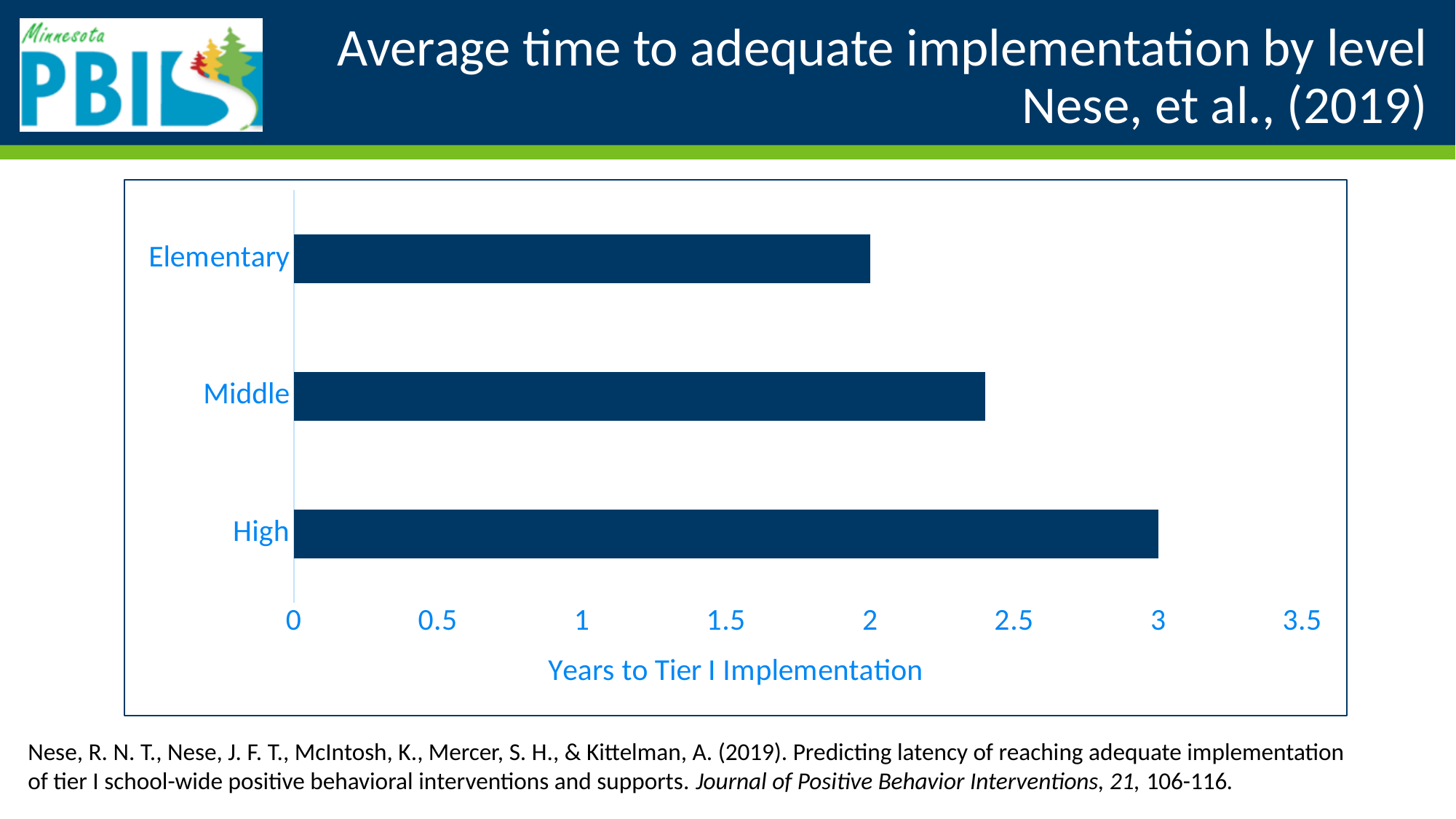
How many years to Tier I implementation are shown for Elementary? 2 Is the value for Middle greater or less than 2? greater How many school levels are plotted in the chart? 3 What is the highest value shown on the horizontal axis? 3.5 Is the value for Middle greater or less than 2.5? less What is the difference in years between High and Elementary? 1 Which school level has the longest average time to Tier I implementation? High What is the label of the horizontal axis? Years to Tier I Implementation Which school level has the shortest average time to Tier I implementation? Elementary What kind of chart is shown on the slide? bar chart How many years to Tier I implementation are shown for High? 3 Which has a larger value, Middle or High? High